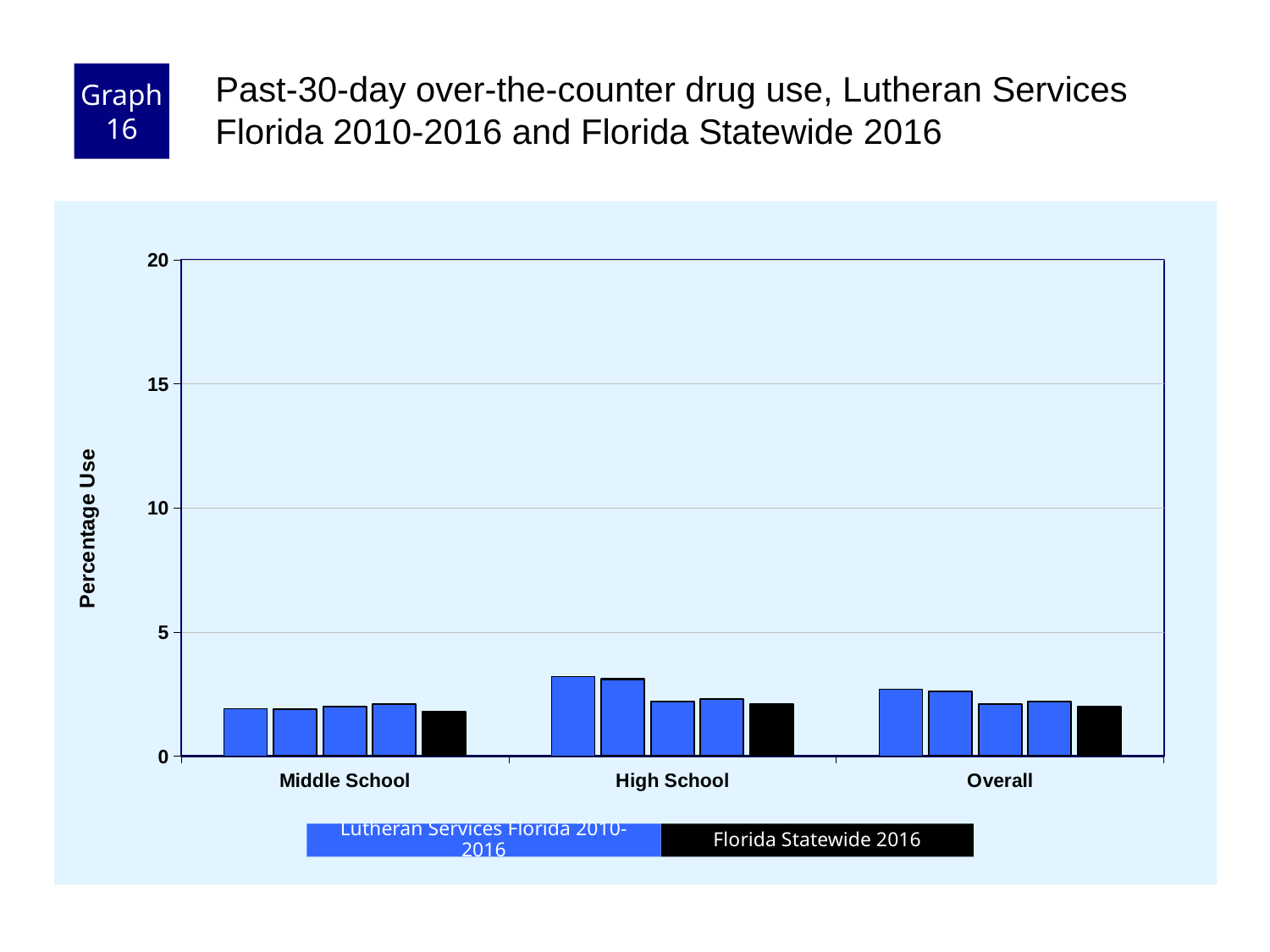
Are any of the bars on the chart greater than 5? No How many categories are shown along the x axis? 3 Which category contains the tallest bar on the chart? High School How many series does the legend list? 2 Is the Florida Statewide 2016 value for Overall greater or less than 10? less Is the Florida Statewide 2016 value for Middle School greater or less than 5? less Which series is shown in black in the legend? Florida Statewide 2016 What is the label on the y axis? Percentage Use What kind of chart is shown on the slide? bar chart Which is larger: the first Lutheran Services Florida bar for High School or the first Lutheran Services Florida bar for Middle School? High School